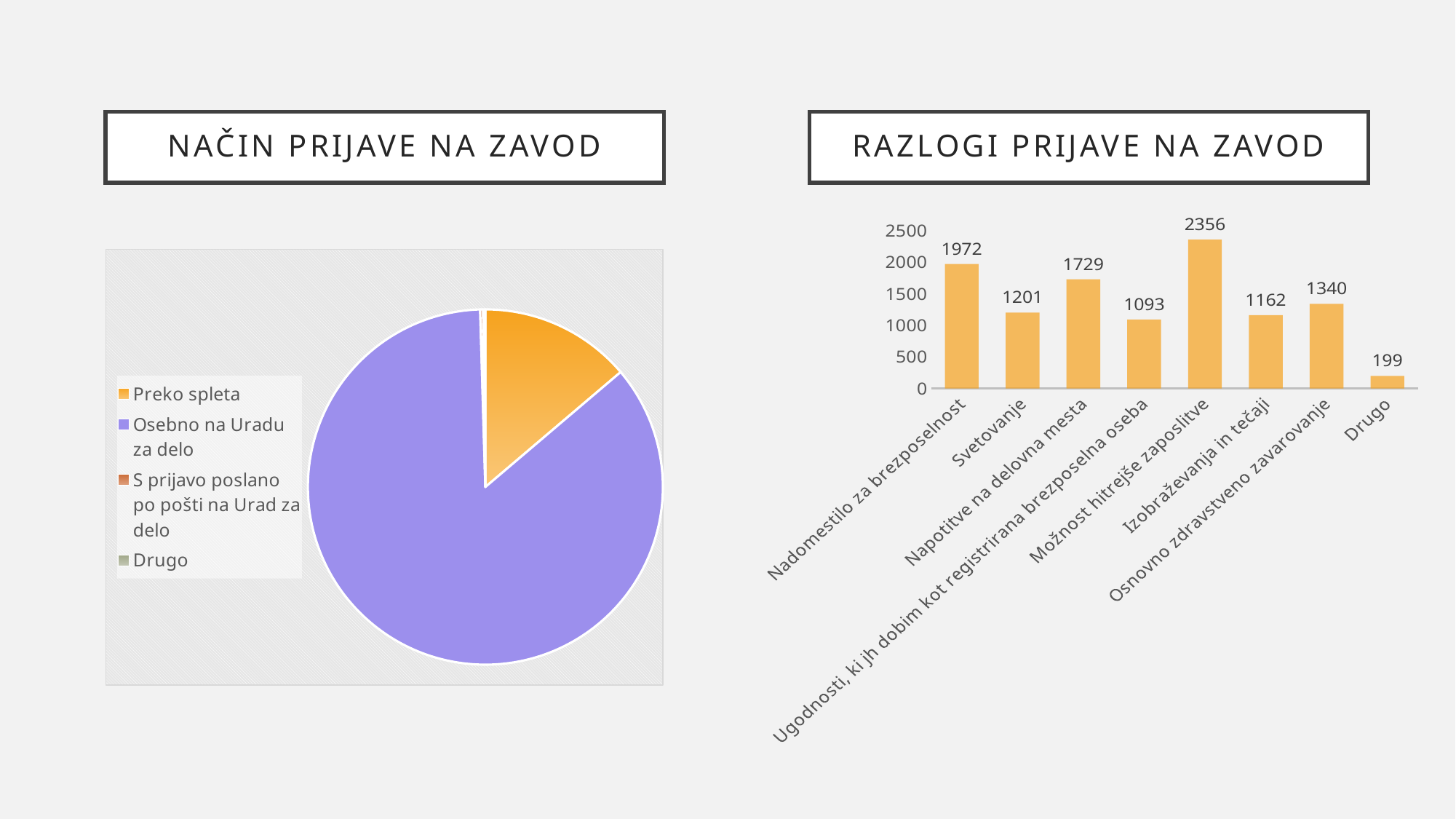
In the chart titled RAZLOGI PRIJAVE NA ZAVOD, what is the value for Drugo? 199 What kind of chart is the one titled NAČIN PRIJAVE NA ZAVOD? Pie chart What kind of chart is the one titled RAZLOGI PRIJAVE NA ZAVOD? Bar chart In the chart titled RAZLOGI PRIJAVE NA ZAVOD, which category has the lowest value? Drugo In the chart titled RAZLOGI PRIJAVE NA ZAVOD, what is the difference between the values for Nadomestilo za brezposelnost and Napotitve na delovna mesta? 243 In the chart titled RAZLOGI PRIJAVE NA ZAVOD, which is larger: Osnovno zdravstveno zavarovanje or Izobraževanja in tečaji? Osnovno zdravstveno zavarovanje In the chart titled RAZLOGI PRIJAVE NA ZAVOD, which category has the highest value? Možnost hitrejše zaposlitve In the chart titled NAČIN PRIJAVE NA ZAVOD, which category has the largest slice? Osebno na Uradu za delo In the chart titled RAZLOGI PRIJAVE NA ZAVOD, what is the value for Svetovanje? 1201 In the chart titled RAZLOGI PRIJAVE NA ZAVOD, what is the value for Možnost hitrejše zaposlitve? 2356 In the chart titled RAZLOGI PRIJAVE NA ZAVOD, how many categories are shown? 8 In the chart titled NAČIN PRIJAVE NA ZAVOD, how many entries does the legend list? 4